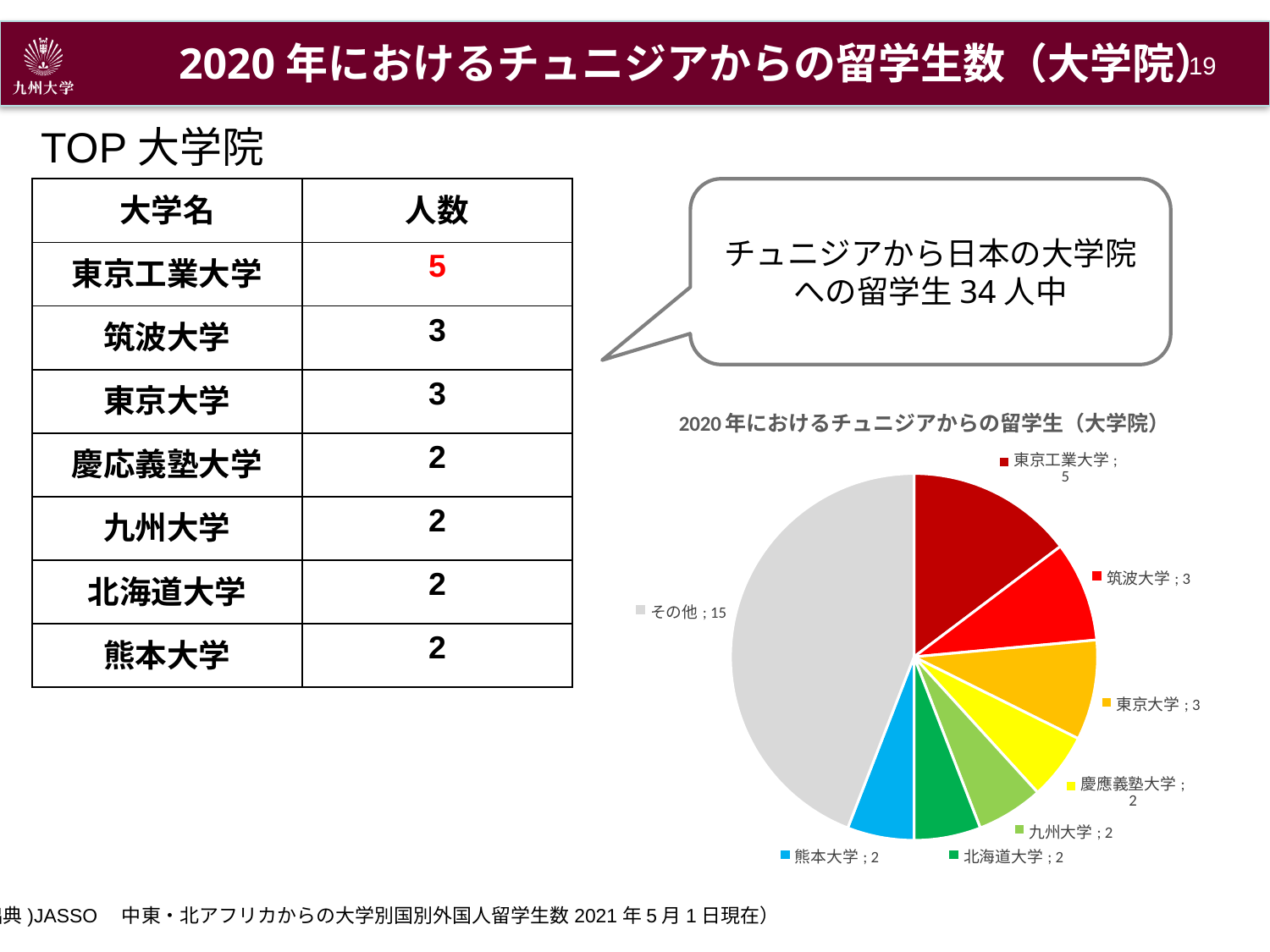
In the pie chart, what is the value for その他? 15 How many slices does the pie chart have? 8 In the pie chart, which is larger: the value for 東京大学 or the value for 九州大学? 東京大学 What is the difference between the values for 東京工業大学 and 筑波大学 in the pie chart? 2 Among the named universities in the pie chart (excluding その他), which has the largest slice? 東京工業大学 In the pie chart, how many students are shown for 東京工業大学? 5 What is the difference between the values for その他 and 東京工業大学 in the pie chart? 10 Which slice of the pie chart is the largest? その他 What is the title of the pie chart? 2020年におけるチュニジアからの留学生（大学院） In the pie chart, what is the value for 熊本大学? 2 In the pie chart, how many students are shown for 筑波大学? 3 What type of chart is shown on the slide? pie chart